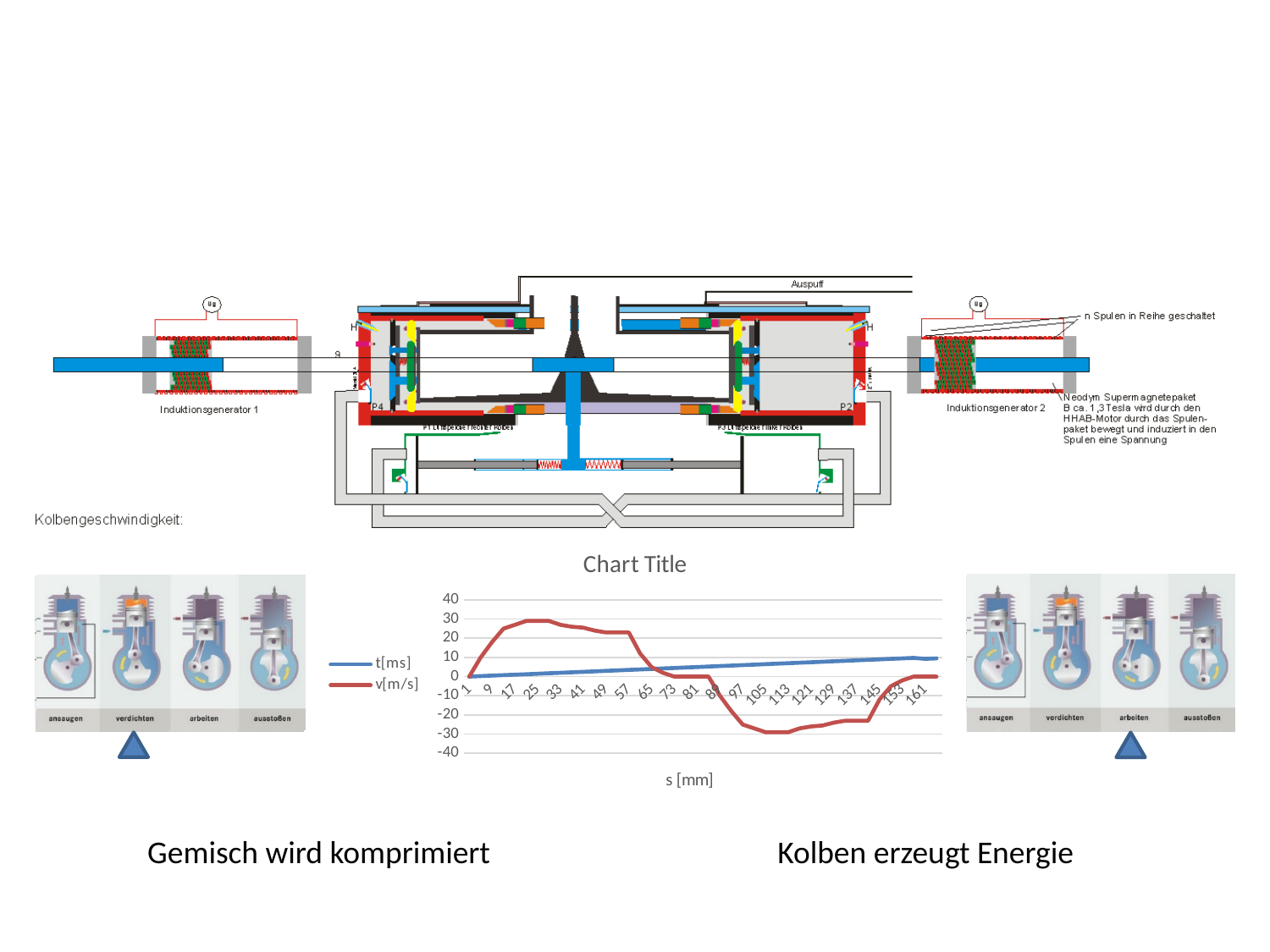
What kind of chart is shown on the slide? line chart At s = 25, which series has the larger value, t[ms] or v[m/s]? v[m/s] Which series reaches the lowest value on the chart? v[m/s] What is the label of the chart's x axis? s [mm] Is the value of v[m/s] at s = 17 greater or less than 20? greater At s = 105, which series has the larger value, t[ms] or v[m/s]? t[ms] What is the title shown above the chart? Chart Title Is the value of v[m/s] at s = 105 greater or less than -20? less How many series does the chart legend list? 2 Which series reaches the highest value on the chart? v[m/s] Does the t[ms] series rise or fall along the x axis? rise